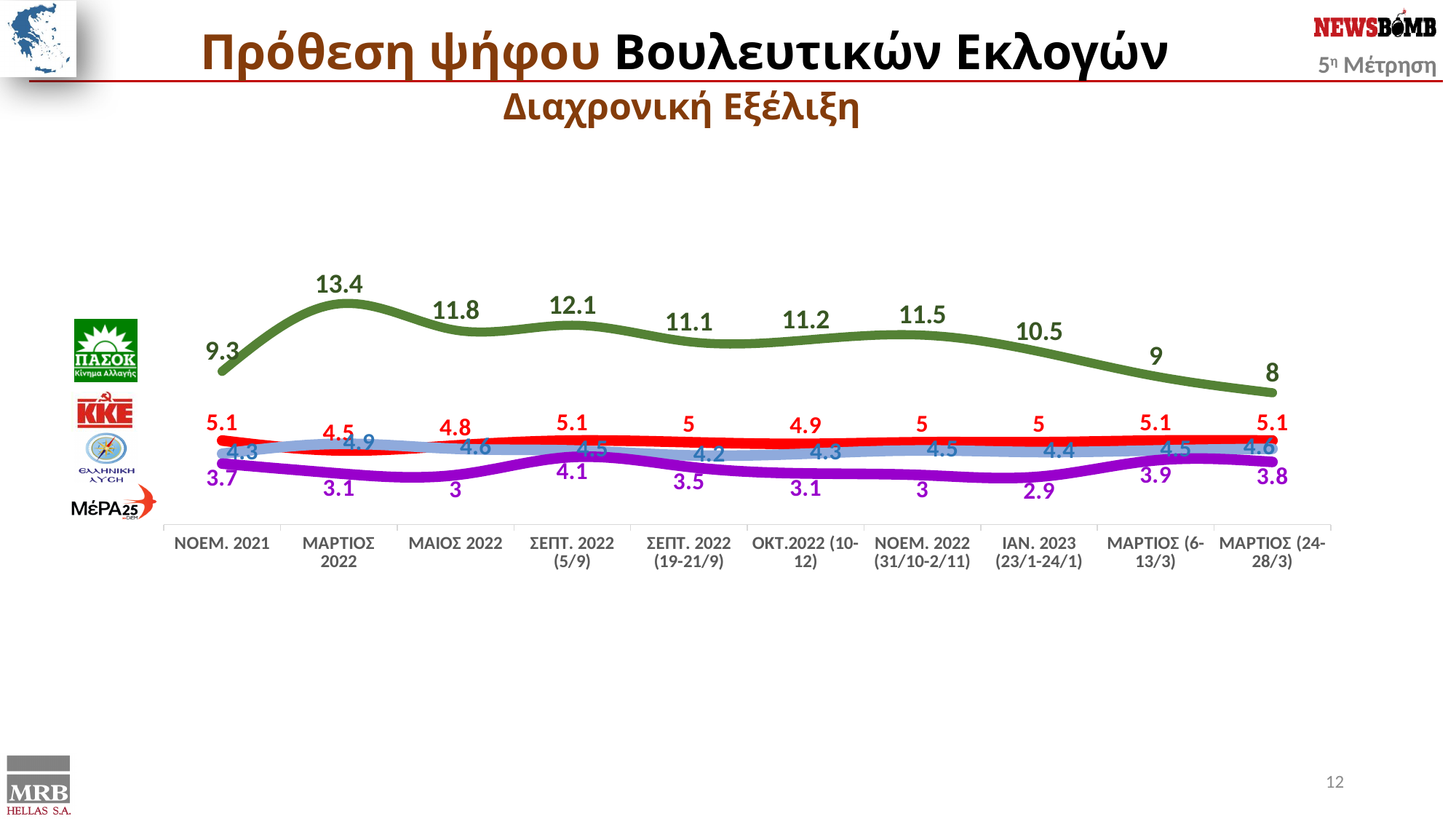
How many time points are shown on the x axis? 10 Which is larger at ΝΟΕΜ. 2021: the ΚΚΕ value or the Ελληνική Λύση value? ΚΚΕ What type of chart is shown on the slide? line chart What is the value of the green ΠΑΣΟΚ line at ΜΑΡΤΙΟΣ 2022? 13.4 What is the difference between the ΠΑΣΟΚ value at ΜΑΡΤΙΟΣ 2022 and at ΜΑΡΤΙΟΣ (24-28/3)? 5.4 What is the value of the light blue Ελληνική Λύση line at ΣΕΠΤ. 2022 (19-21/9)? 4.2 What is the value of the purple ΜέΡΑ25 line at ΙΑΝ. 2023 (23/1-24/1)? 2.9 Does the green ΠΑΣΟΚ line rise or fall from ΝΟΕΜ. 2022 (31/10-2/11) to ΜΑΡΤΙΟΣ (24-28/3)? fall What is the value of the red ΚΚΕ line at ΜΑΙΟΣ 2022? 4.8 At which time point does the purple ΜέΡΑ25 line reach its lowest value? ΙΑΝ. 2023 (23/1-24/1) At which time point does the green ΠΑΣΟΚ line reach its highest value? ΜΑΡΤΙΟΣ 2022 What is the value of the green ΠΑΣΟΚ line at ΜΑΡΤΙΟΣ (24-28/3)? 8